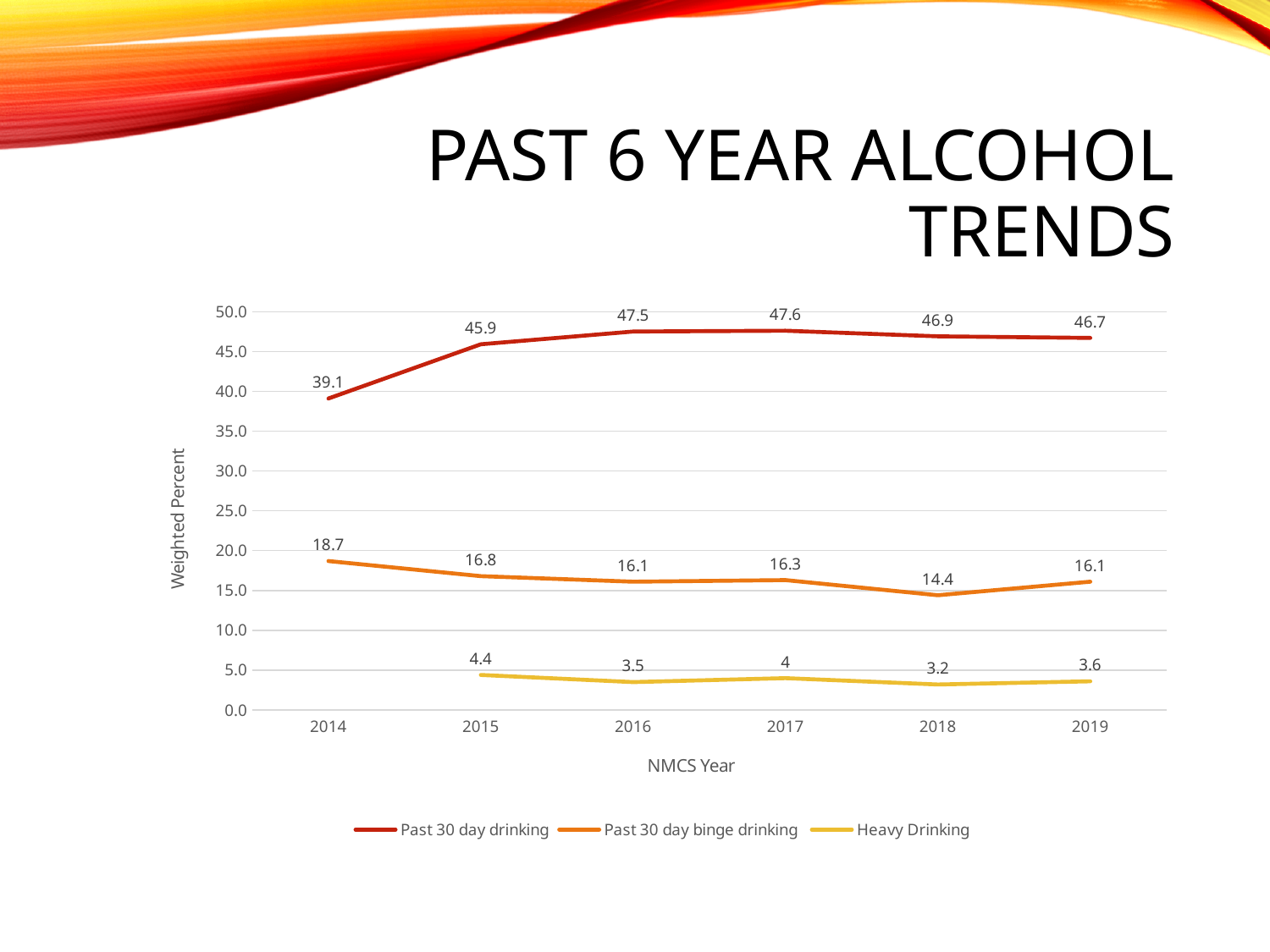
What type of chart is shown on the slide? line chart How many series does the legend list? 3 Is the value for Past 30 day drinking in 2016 greater or less than 45.0? greater What is the label of the y axis? Weighted Percent In which year is Past 30 day drinking highest? 2017 In which year is Past 30 day binge drinking lowest? 2018 What is the value for Past 30 day binge drinking in 2018? 14.4 What is the difference between Past 30 day drinking in 2017 and in 2014? 8.5 What is the value for Past 30 day drinking in 2014? 39.1 What is the value for Heavy Drinking in 2017? 4 Which is larger, Past 30 day binge drinking in 2015 or in 2019? 2015 How many years are shown on the x axis? 6